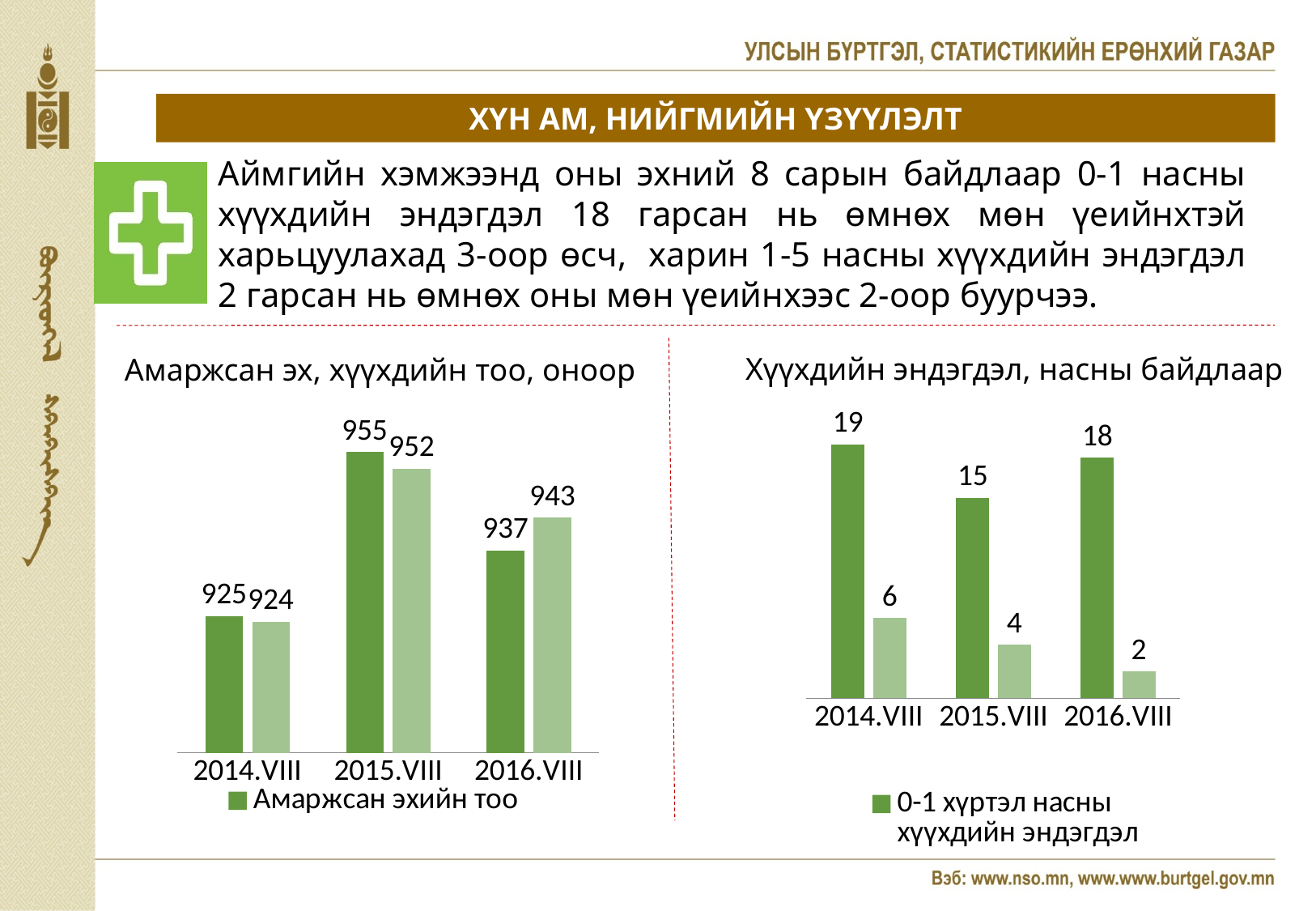
In the chart titled "Хүүхдийн эндэгдэл, насны байдлаар", what is the value of the light green bar for 2014.VIII? 6 In the chart titled "Хүүхдийн эндэгдэл, насны байдлаар", do the light green bars rise or fall from 2014.VIII to 2016.VIII? fall In the chart titled "Хүүхдийн эндэгдэл, насны байдлаар", which year has the lowest value for 0-1 хүртэл насны хүүхдийн эндэгдэл? 2015.VIII In the chart titled "Амаржсан эх, хүүхдийн тоо, оноор", what is the value of the light green bar for 2016.VIII? 943 In the chart titled "Хүүхдийн эндэгдэл, насны байдлаар", what is the difference between the 0-1 хүртэл насны хүүхдийн эндэгдэл values for 2014.VIII and 2015.VIII? 4 In the chart titled "Амаржсан эх, хүүхдийн тоо, оноор", what is the difference between the Амаржсан эхийн тоо values for 2015.VIII and 2014.VIII? 30 What type of chart is the chart titled "Хүүхдийн эндэгдэл, насны байдлаар"? bar chart In the chart titled "Амаржсан эх, хүүхдийн тоо, оноор", how many years are shown on the x axis? 3 In the chart titled "Хүүхдийн эндэгдэл, насны байдлаар", what is the value of 0-1 хүртэл насны хүүхдийн эндэгдэл for 2016.VIII? 18 In the chart titled "Хүүхдийн эндэгдэл, насны байдлаар", which is larger: the dark green bar for 2016.VIII or the dark green bar for 2015.VIII? 2016.VIII In the chart titled "Амаржсан эх, хүүхдийн тоо, оноор", which year has the highest value for Амаржсан эхийн тоо? 2015.VIII In the chart titled "Амаржсан эх, хүүхдийн тоо, оноор", what is the value of the dark green bar (Амаржсан эхийн тоо) for 2015.VIII? 955